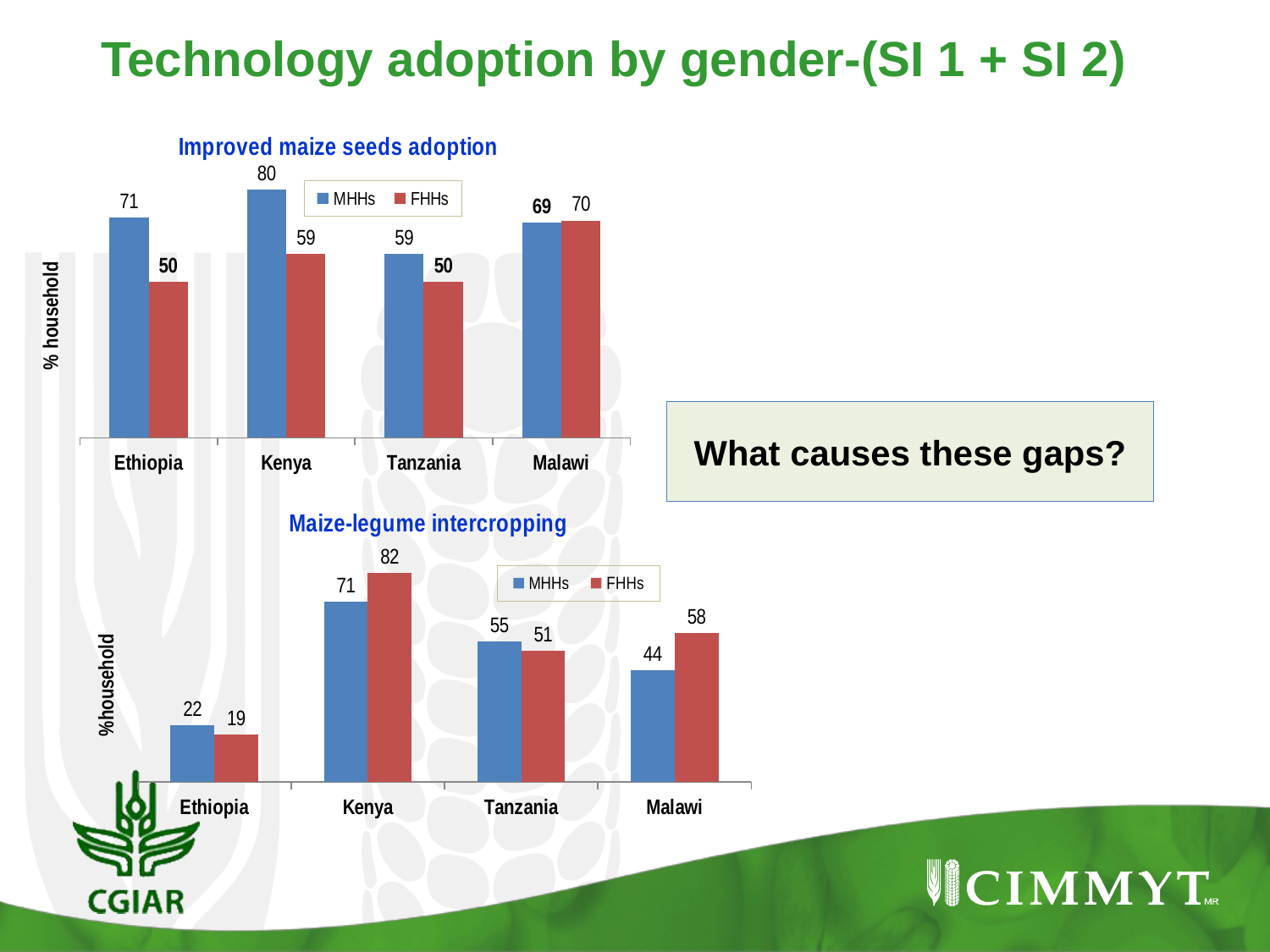
In the 'Maize-legume intercropping' chart, what is the difference between FHHs and MHHs in Malawi? 14 In the 'Improved maize seeds adoption' chart, what is the value for MHHs in Kenya? 80 How many series does the legend of the 'Improved maize seeds adoption' chart list? 2 In the 'Maize-legume intercropping' chart, what is the value for FHHs in Kenya? 82 In the 'Maize-legume intercropping' chart, what is the value for MHHs in Malawi? 44 In the 'Improved maize seeds adoption' chart, which is larger in Malawi, MHHs or FHHs? FHHs In the 'Improved maize seeds adoption' chart, which country has the highest MHHs value? Kenya In the 'Maize-legume intercropping' chart, which country has the lowest FHHs value? Ethiopia In the 'Improved maize seeds adoption' chart, what is the difference between MHHs and FHHs in Ethiopia? 21 How many countries are shown on the x axis of the 'Maize-legume intercropping' chart? 4 In the 'Improved maize seeds adoption' chart, what is the value for FHHs in Ethiopia? 50 What type of chart is the 'Maize-legume intercropping' chart? Bar chart